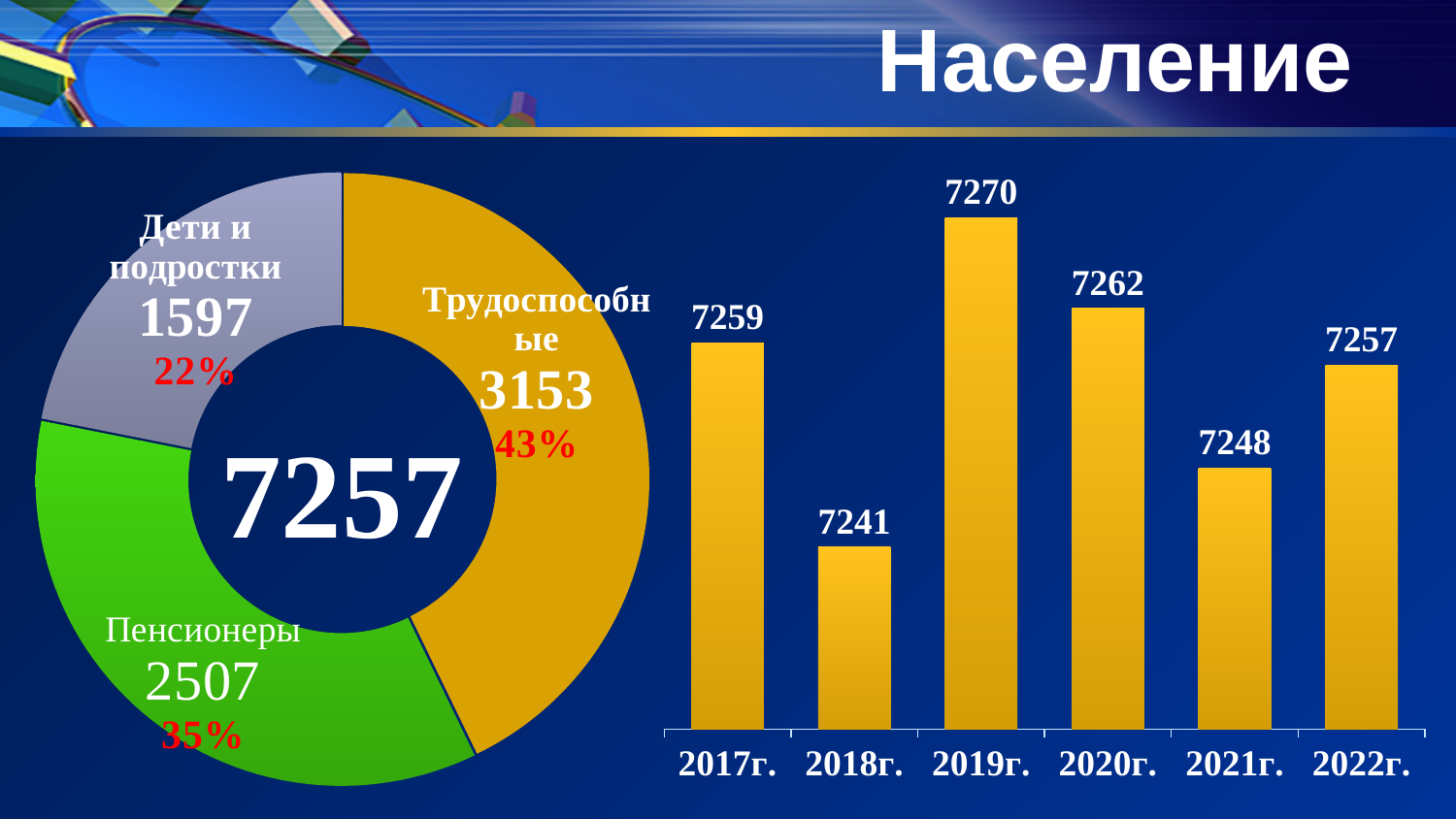
How many years are shown in the bar chart on the right? 6 In the doughnut chart on the left, what percentage share does Трудоспособные have? 43% What kind of chart is on the right side of the slide? bar chart In the bar chart on the right, what is the difference between the values for 2019г. and 2018г.? 29 In the doughnut chart on the left, which category has the smallest value? Дети и подростки What number is shown in the centre of the doughnut chart on the left? 7257 In the bar chart on the right, which year has the highest value? 2019г. In the bar chart on the right, which year has the lowest value? 2018г. In the bar chart on the right, what is the value for 2021г.? 7248 In the bar chart on the right, what is the value for 2019г.? 7270 In the bar chart on the right, which is larger: the value for 2020г. or the value for 2022г.? 2020г. In the doughnut chart on the left, what is the value for Пенсионеры? 2507